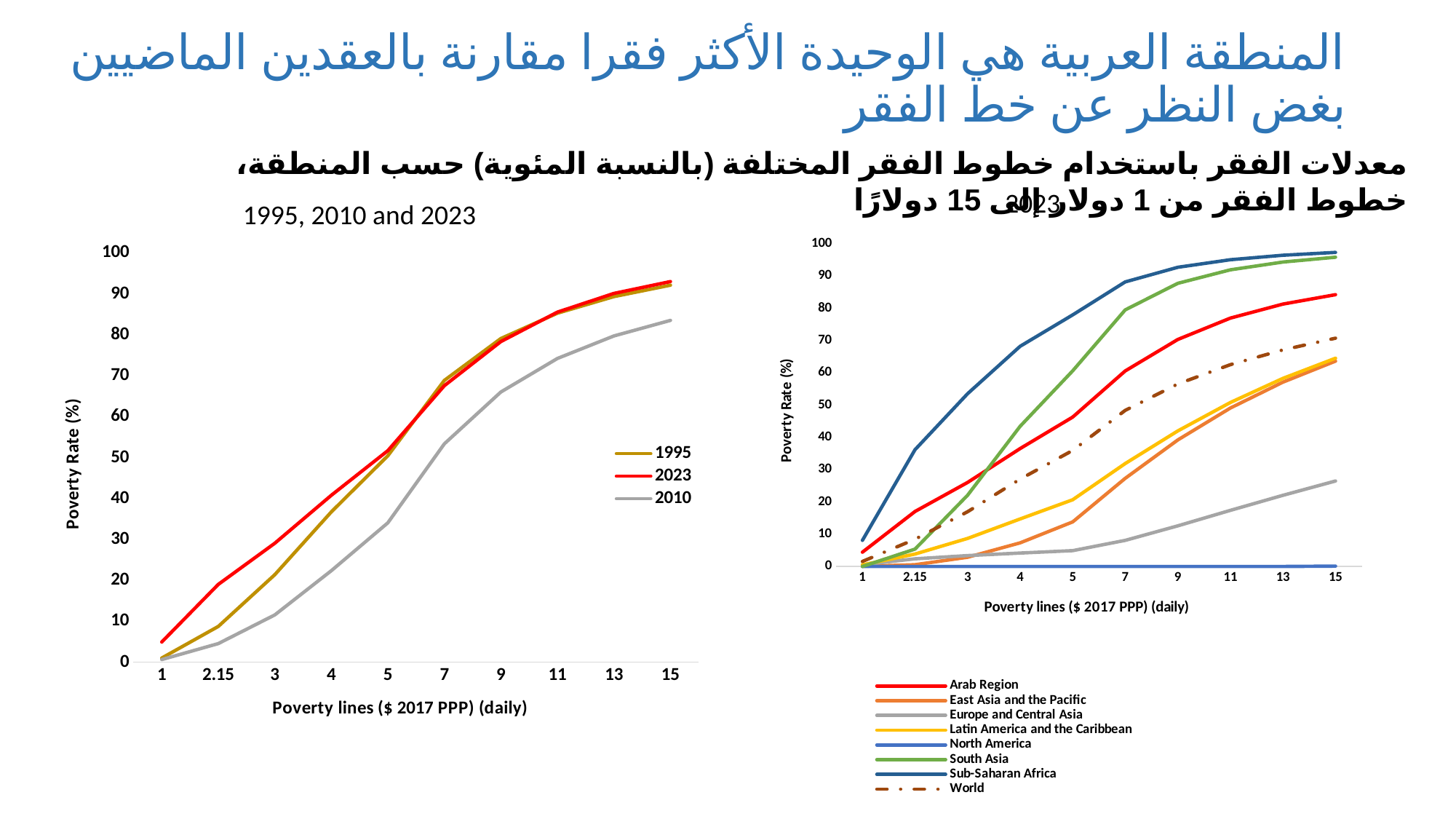
In the right chart ('2023'), which is larger at the $15 poverty line: Arab Region or Sub-Saharan Africa? Sub-Saharan Africa In the left chart ('1995, 2010 and 2023'), is the 2010 value at the $5 poverty line greater or less than 40? less In the right chart ('2023'), is the Sub-Saharan Africa value at the $4 poverty line greater or less than 60? greater In the left chart ('1995, 2010 and 2023'), which series has the lowest value at the $5 poverty line? 2010 How many poverty-line points are plotted along the x axis of the right chart ('2023')? 10 In the left chart ('1995, 2010 and 2023'), is the 2023 value at the $3 poverty line greater or less than 20? greater In the right chart ('2023'), which series has the lowest value at the $15 poverty line? North America In the right chart ('2023'), does the Arab Region line rise or fall as the poverty line increases from $1 to $15? rise What type of chart is the left chart titled '1995, 2010 and 2023'? line chart How many series does the legend of the right chart ('2023') list? 8 How many series does the legend of the left chart ('1995, 2010 and 2023') list? 3